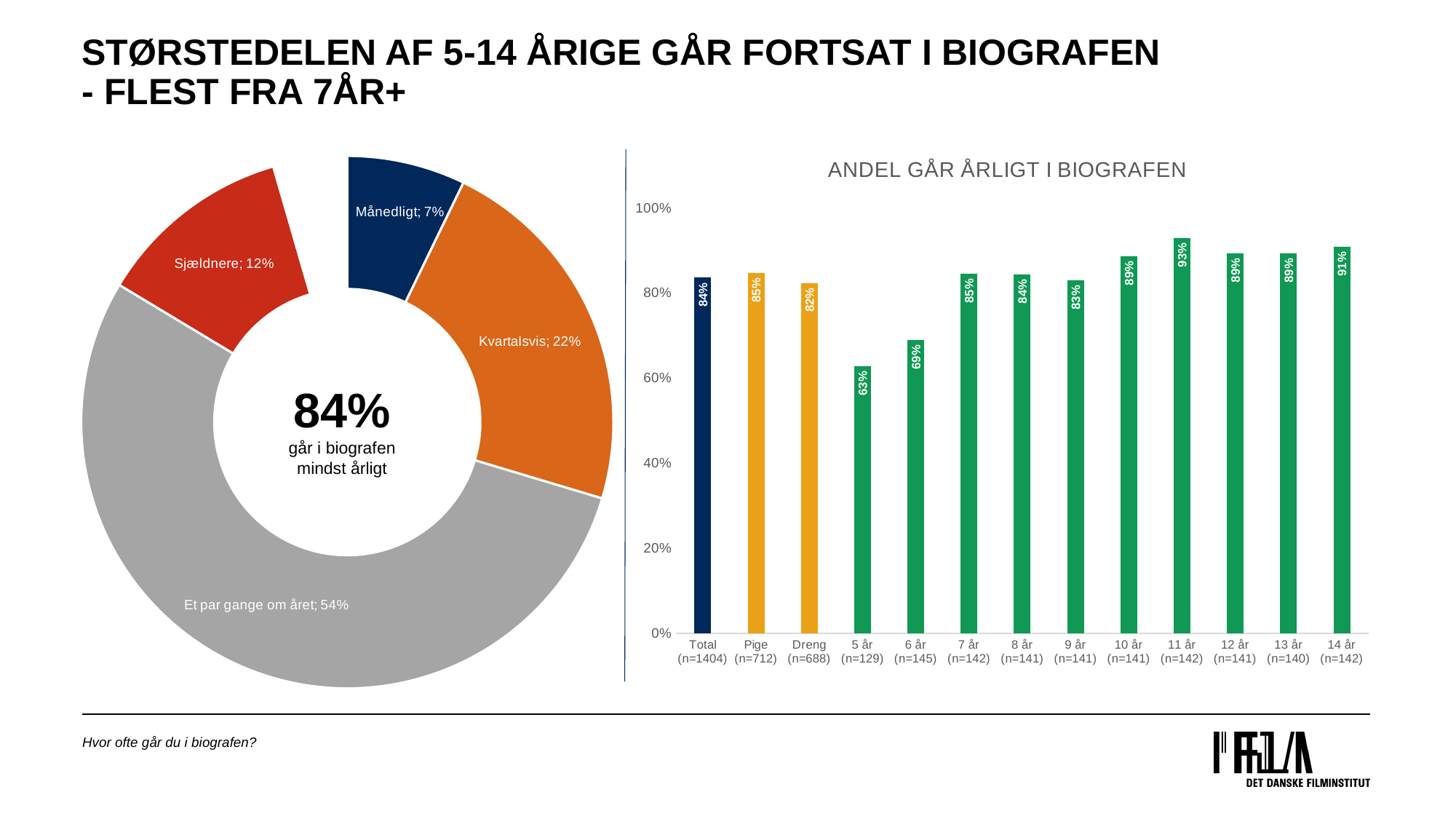
In the bar chart 'ANDEL GÅR ÅRLIGT I BIOGRAFEN', which category has the lowest value? 5 år What kind of chart is the chart on the left side of the slide? Doughnut chart In the bar chart 'ANDEL GÅR ÅRLIGT I BIOGRAFEN', which category has the highest value? 11 år In the bar chart 'ANDEL GÅR ÅRLIGT I BIOGRAFEN', what is the value for 5 år? 63% In the doughnut chart on the left, what is the share for 'Månedligt'? 7% In the bar chart 'ANDEL GÅR ÅRLIGT I BIOGRAFEN', is the value for 6 år greater or less than 80%? less In the doughnut chart on the left, which slice is the largest? Et par gange om året In the bar chart 'ANDEL GÅR ÅRLIGT I BIOGRAFEN', what is the value for Pige? 85% In the bar chart 'ANDEL GÅR ÅRLIGT I BIOGRAFEN', which is larger, the value for Pige or the value for Dreng? Pige In the doughnut chart on the left, what is the share for 'Et par gange om året'? 54% In the bar chart 'ANDEL GÅR ÅRLIGT I BIOGRAFEN', what is the difference between the values for 14 år and 5 år? 28% In the bar chart 'ANDEL GÅR ÅRLIGT I BIOGRAFEN', how many categories are shown on the x axis? 13